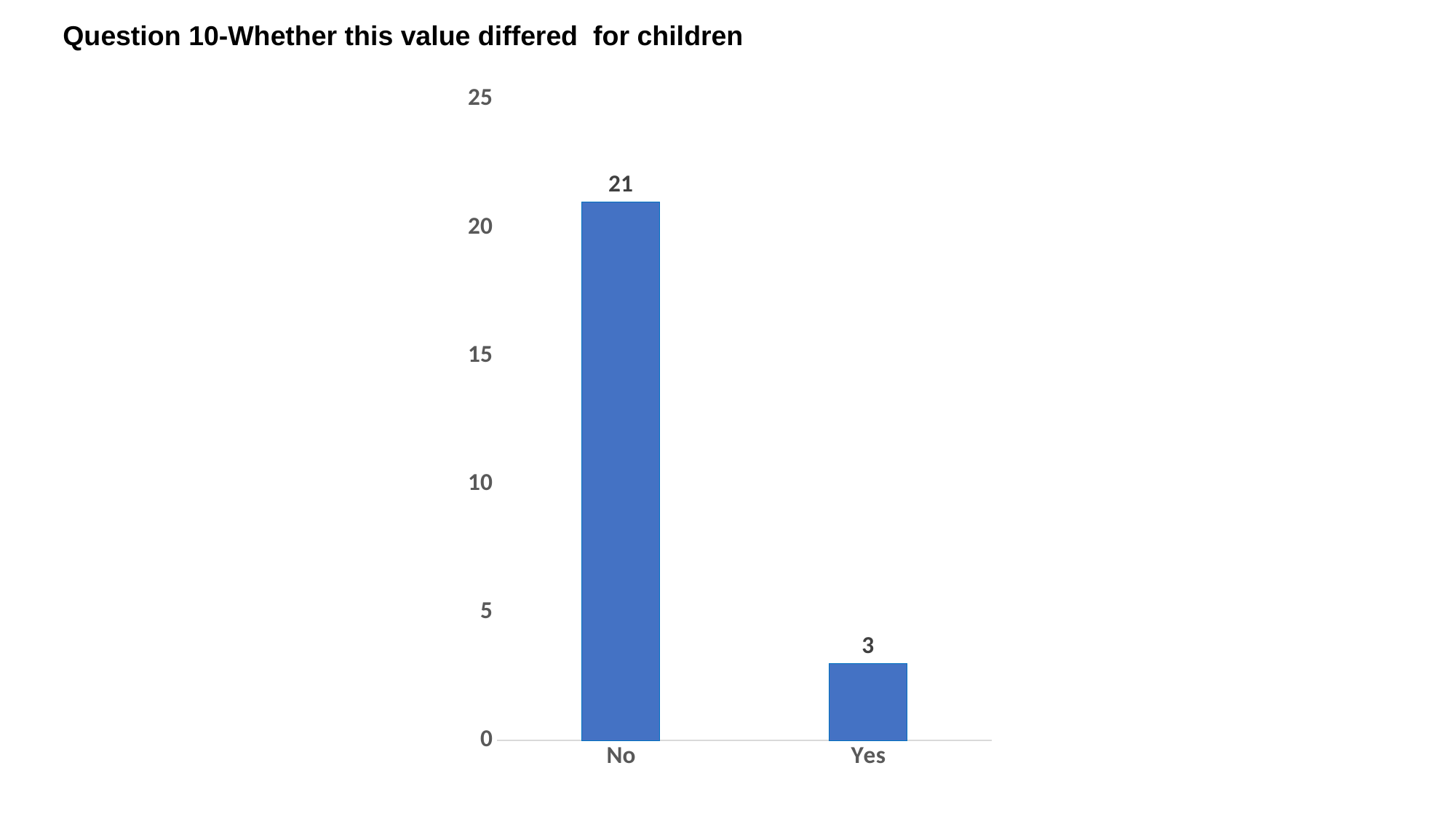
What is the total of the values for No and Yes? 24 What is the value for Yes? 3 What is the value for No? 21 Is the value for No greater or less than 20? greater What kind of chart is shown on the slide? bar chart Which is larger, the value for No or the value for Yes? No Which category has the highest value? No What is the difference between the values for No and Yes? 18 How many categories are shown on the x axis? 2 What is the title of the chart? Question 10-Whether this value differed for children Which category has the lowest value? Yes Is the value for Yes greater or less than 5? less